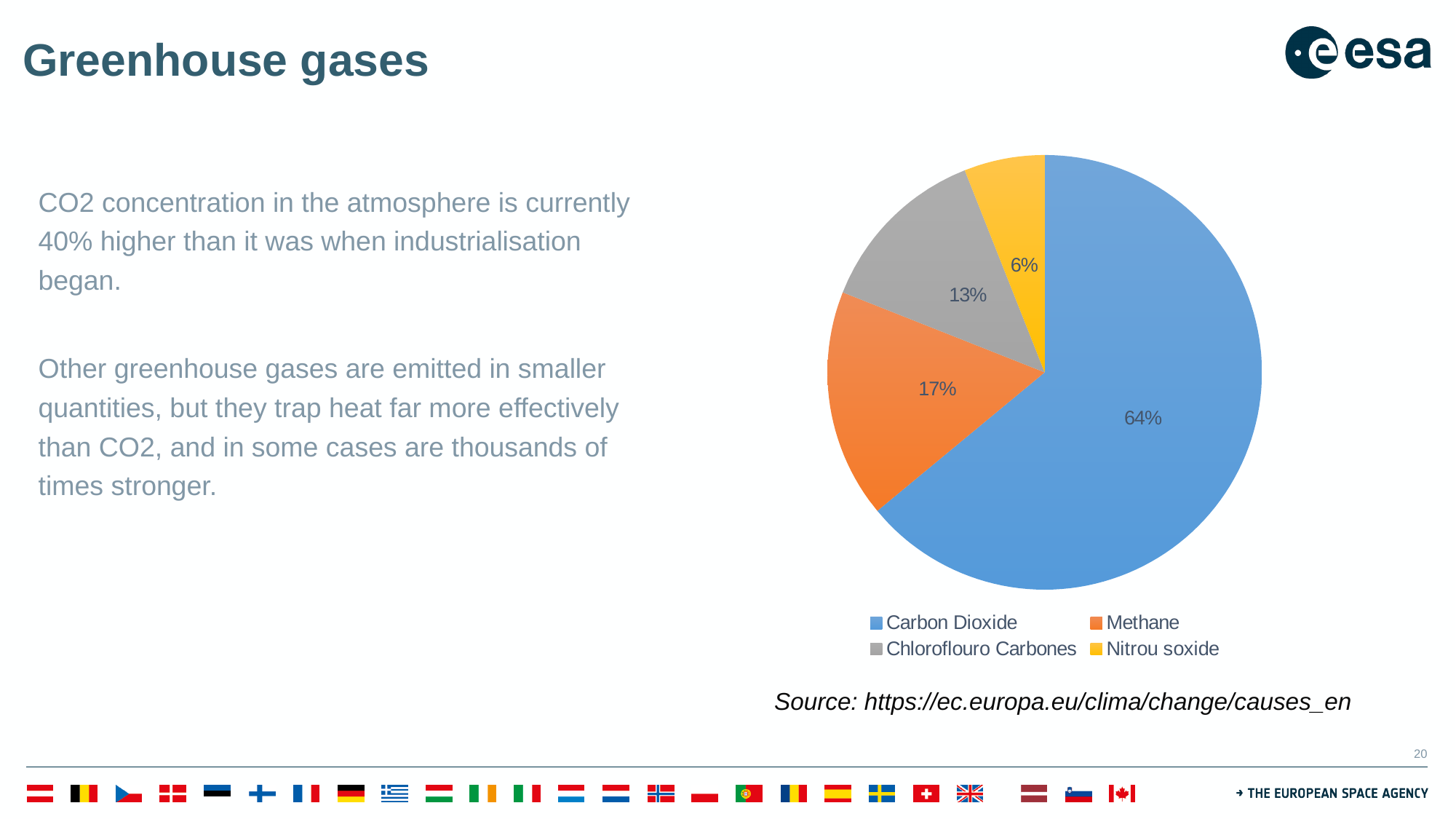
What is the difference between the Methane share and the Chloroflouro Carbones share? 4% What share of the pie does Nitrou soxide have? 6% What share of the pie does Carbon Dioxide have? 64% Which is larger, the share for Methane or the share for Nitrou soxide? Methane What kind of chart is shown on the slide? pie chart What colour is the Methane slice in the pie chart? orange Which gas has the smallest slice of the pie? Nitrou soxide What is the difference between the Carbon Dioxide share and the Methane share? 47% How many categories does the pie chart show? 4 What share of the pie does Chloroflouro Carbones have? 13% Which gas has the largest slice of the pie? Carbon Dioxide